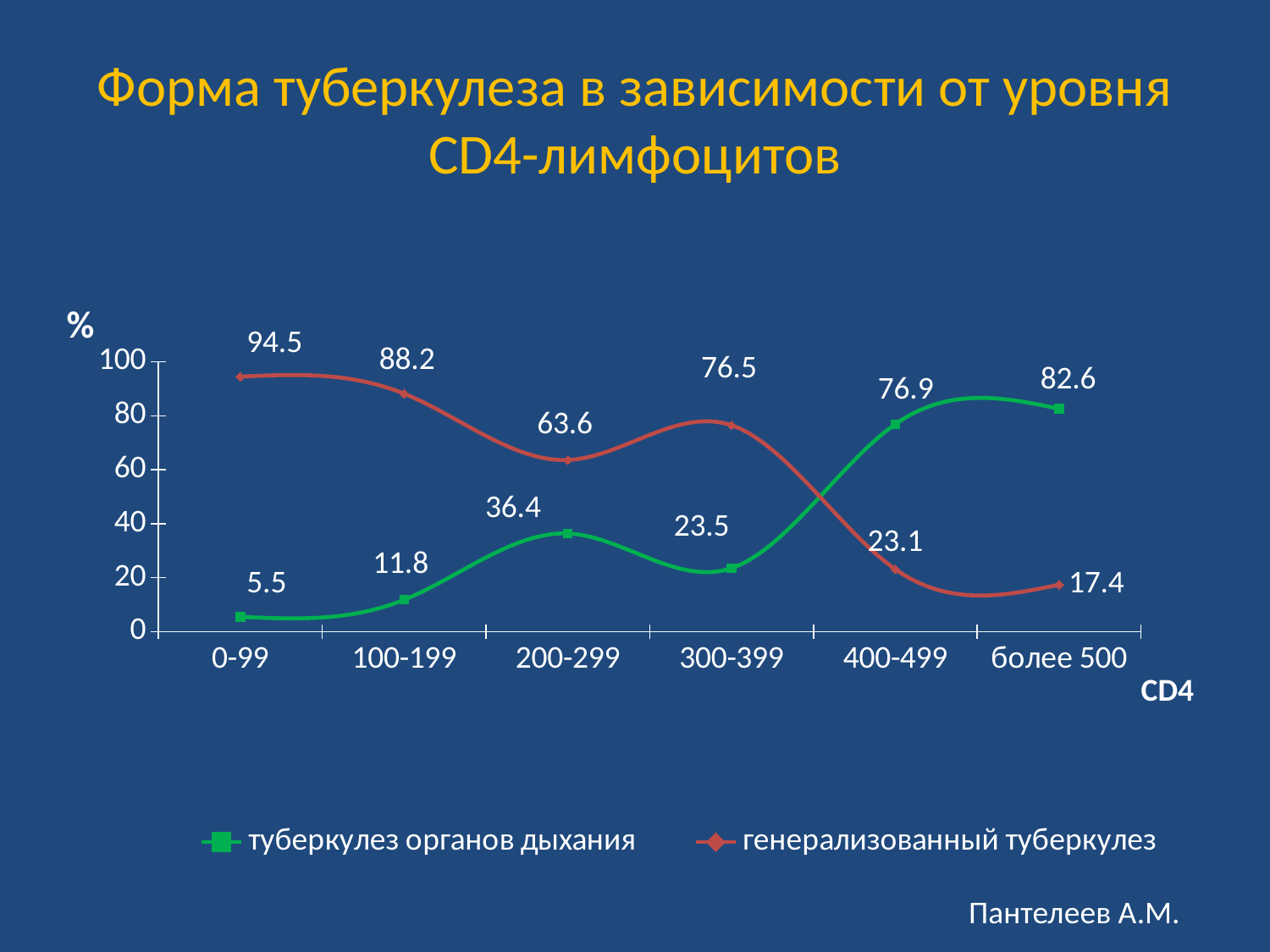
What is the value for туберкулез органов дыхания at CD4 level 200-299? 36.4 At which CD4 level is the value for генерализованный туберкулез the lowest? более 500 How many CD4 level categories are shown on the x axis? 6 What is the difference between the two series at CD4 level 300-399? 53 At which CD4 level is the value for туберкулез органов дыхания the highest? более 500 What is the value for генерализованный туберкулез at CD4 level 0-99? 94.5 What is the value for туберкулез органов дыхания at CD4 level более 500? 82.6 Which series has the larger value at CD4 level 400-499? туберкулез органов дыхания What kind of chart is shown on the slide? line chart Is the value for генерализованный туберкулез at CD4 level 200-299 greater or less than 60? greater How many series does the legend list? 2 What colour is the line for генерализованный туберкулез? red